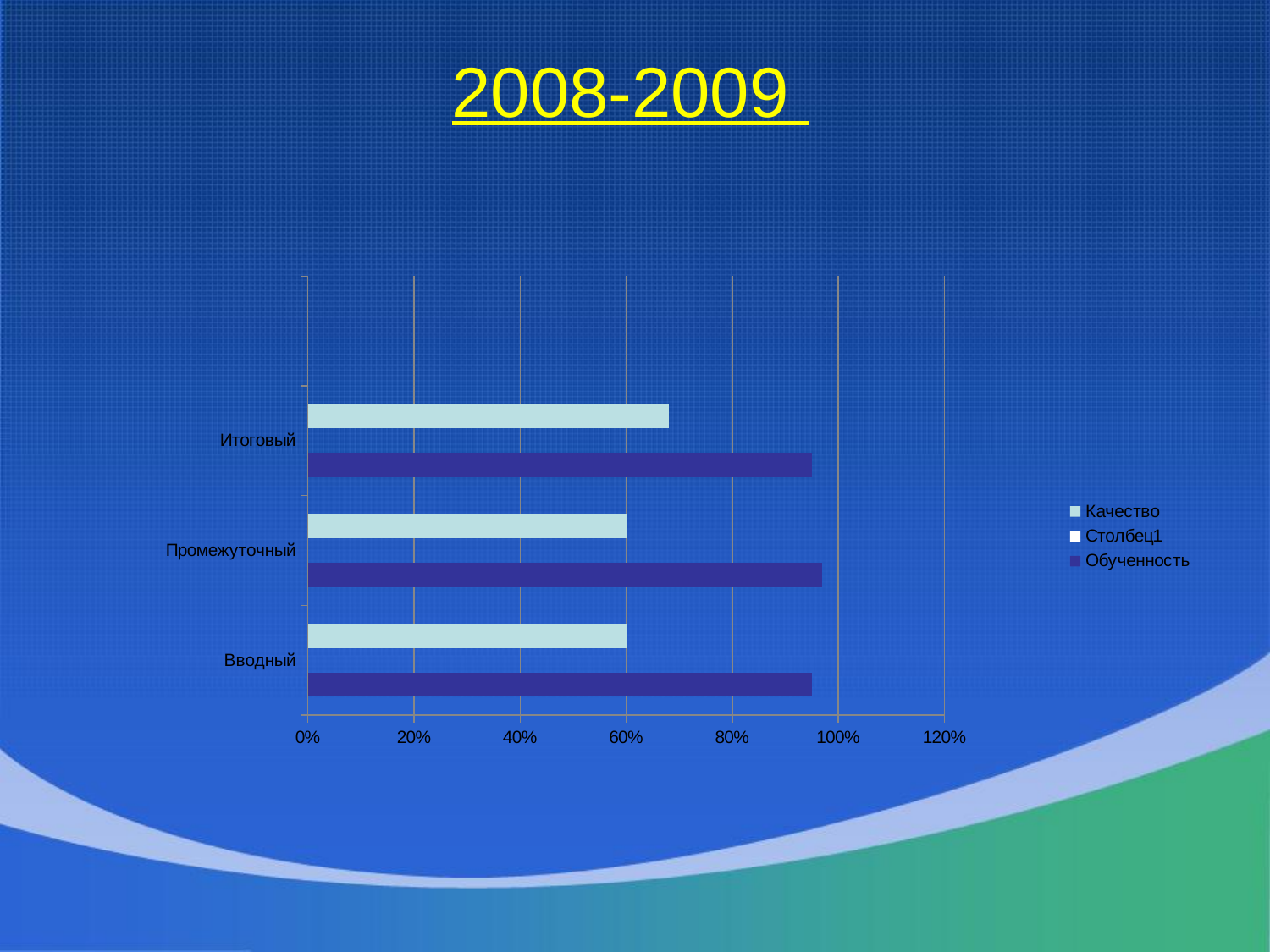
Is the value of Обученность for Промежуточный greater or less than 100%? less For Итоговый, which is larger: Качество or Обученность? Обученность Is the value of Качество for Вводный greater or less than 40%? greater Which legend entry is shown in dark blue? Обученность What kind of chart is shown on the slide? bar chart What is the title of the slide containing the chart? 2008-2009 Is the value of Качество for Итоговый greater or less than 80%? less How many categories are shown on the vertical axis of the chart? 3 How many series does the chart legend list? 3 For Промежуточный, which is larger: Качество or Обученность? Обученность Which category has the highest value for Качество? Итоговый